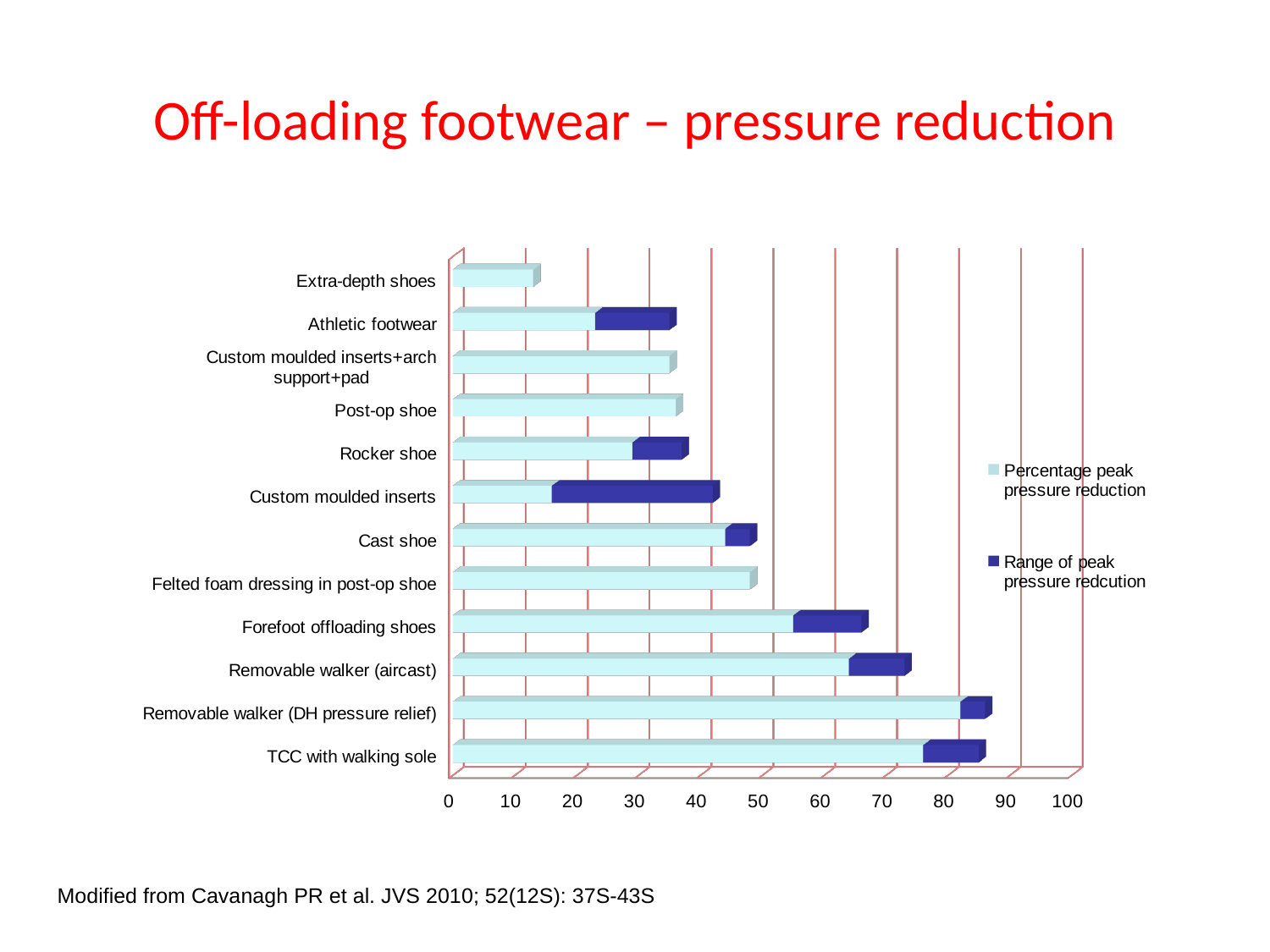
Which footwear category has the lowest percentage peak pressure reduction? Extra-depth shoes Which footwear category has the highest percentage peak pressure reduction (light blue bar)? Removable walker (DH pressure relief) What are the two series named in the legend? Percentage peak pressure reduction; Range of peak pressure redcution Which has a larger percentage peak pressure reduction, Custom moulded inserts or Cast shoe? Cast shoe Is the percentage peak pressure reduction for Extra-depth shoes greater or less than 20? less Is the percentage peak pressure reduction for Athletic footwear greater or less than 30? less Which has a larger percentage peak pressure reduction, Removable walker (aircast) or Rocker shoe? Removable walker (aircast) How many footwear categories are plotted on the chart? 12 Is the percentage peak pressure reduction for Forefoot offloading shoes greater or less than 50? greater How many series does the legend list? 2 What kind of chart is shown on the slide? bar chart